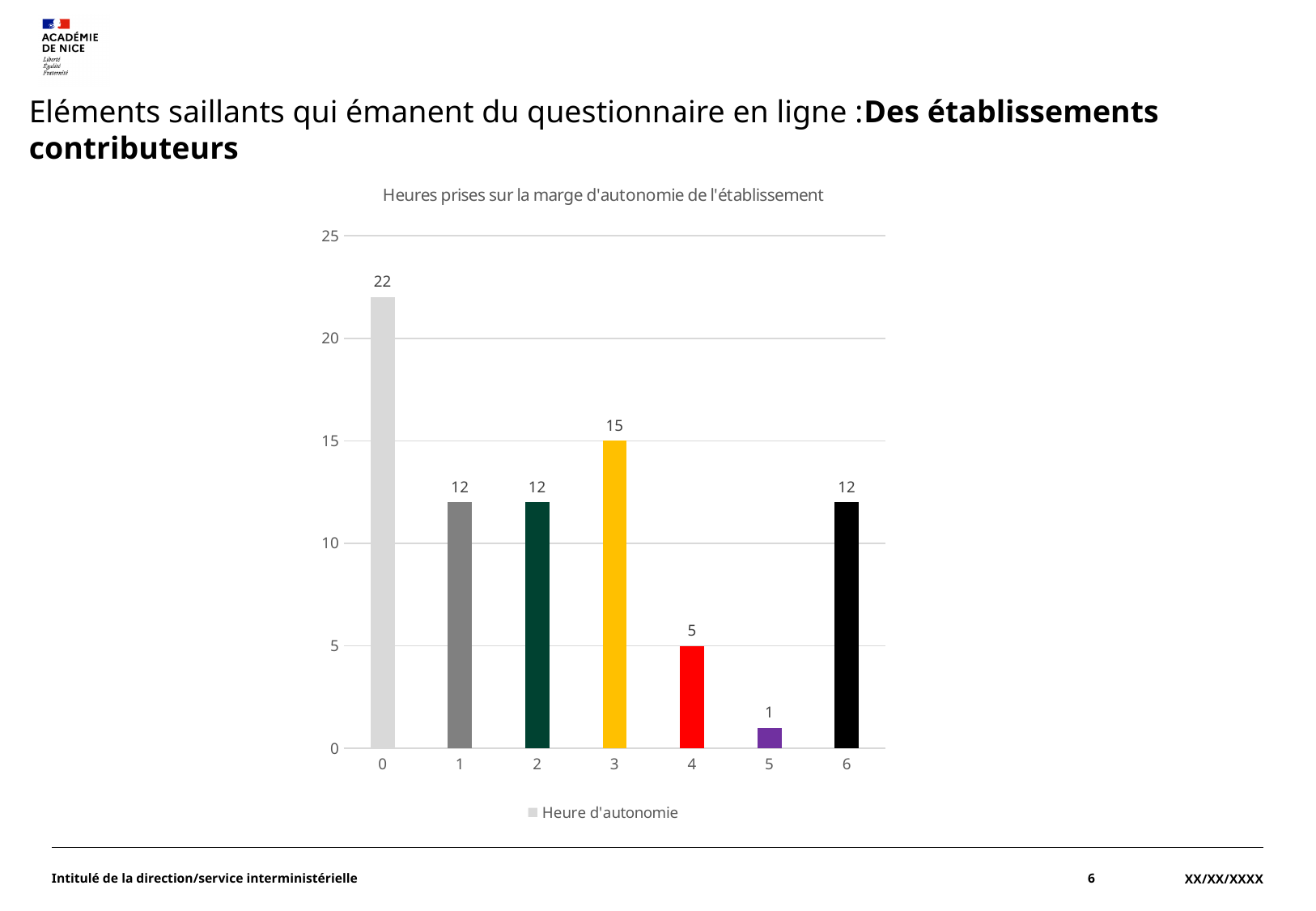
What kind of chart is shown? bar chart What is the value for category 5? 1 What is the title of the chart? Heures prises sur la marge d'autonomie de l'établissement Is the value for category 3 greater or less than 10? greater Which category has the highest value? 0 How many series does the legend list? 1 What is the difference between the values for category 0 and category 3? 7 Which is larger, the value for category 4 or the value for category 6? 6 What is the value for category 0? 22 What is the value for category 3? 15 How many categories are shown on the x axis? 7 Which category has the lowest value? 5